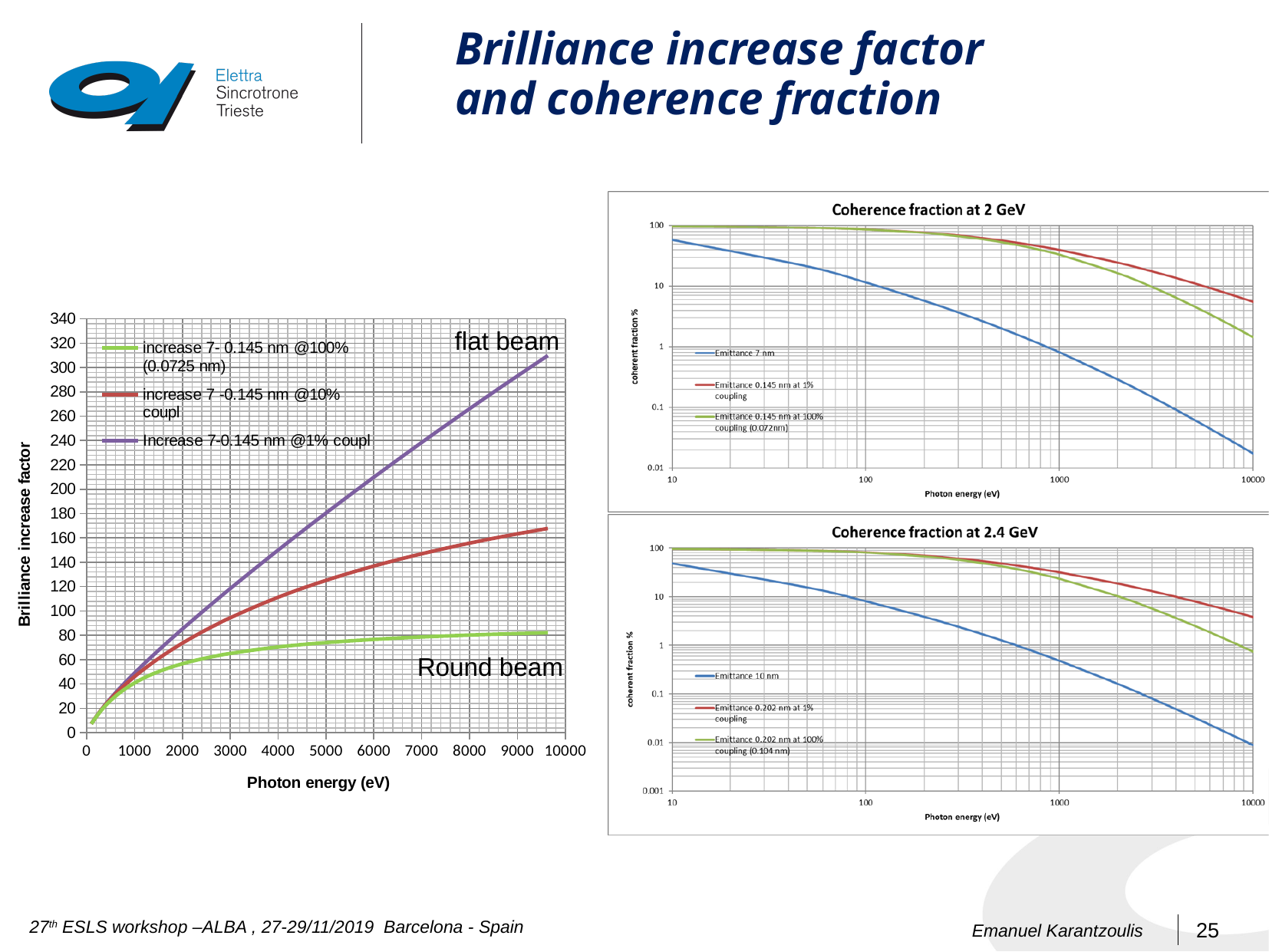
How many series does the legend of the 'Coherence fraction at 2.4 GeV' chart list? 3 What is the y-axis label of the 'Coherence fraction at 2.4 GeV' chart? coherent fraction % In the left Brilliance increase factor chart, which series has the lowest values at 9000 eV? increase 7- 0.145 nm @100% (0.0725 nm) In the left Brilliance increase factor chart, do the series rise or fall as photon energy increases? rise In the 'Coherence fraction at 2 GeV' chart, is the value of the 'Emittance 7 nm' series at 10000 eV greater or less than 0.1? less In the left Brilliance increase factor chart, which series reaches the highest value at the right end of the x axis? Increase 7-0.145 nm @1% coupl In the left Brilliance increase factor chart, is the value of the 'increase 7- 0.145 nm @100% (0.0725 nm)' series at 9000 eV greater or less than 100? less In the left Brilliance increase factor chart, is the value of the 'Increase 7-0.145 nm @1% coupl' series at 5000 eV greater or less than 160? greater What kind of chart is the left chart showing Brilliance increase factor against Photon energy? line chart In the 'Coherence fraction at 2 GeV' chart, do the curves rise or fall as photon energy increases? fall In the left Brilliance increase factor chart, at 8000 eV which is larger: the 'increase 7 -0.145 nm @10% coupl' series or the 'Increase 7-0.145 nm @1% coupl' series? Increase 7-0.145 nm @1% coupl How many series does the legend of the left Brilliance increase factor chart list? 3